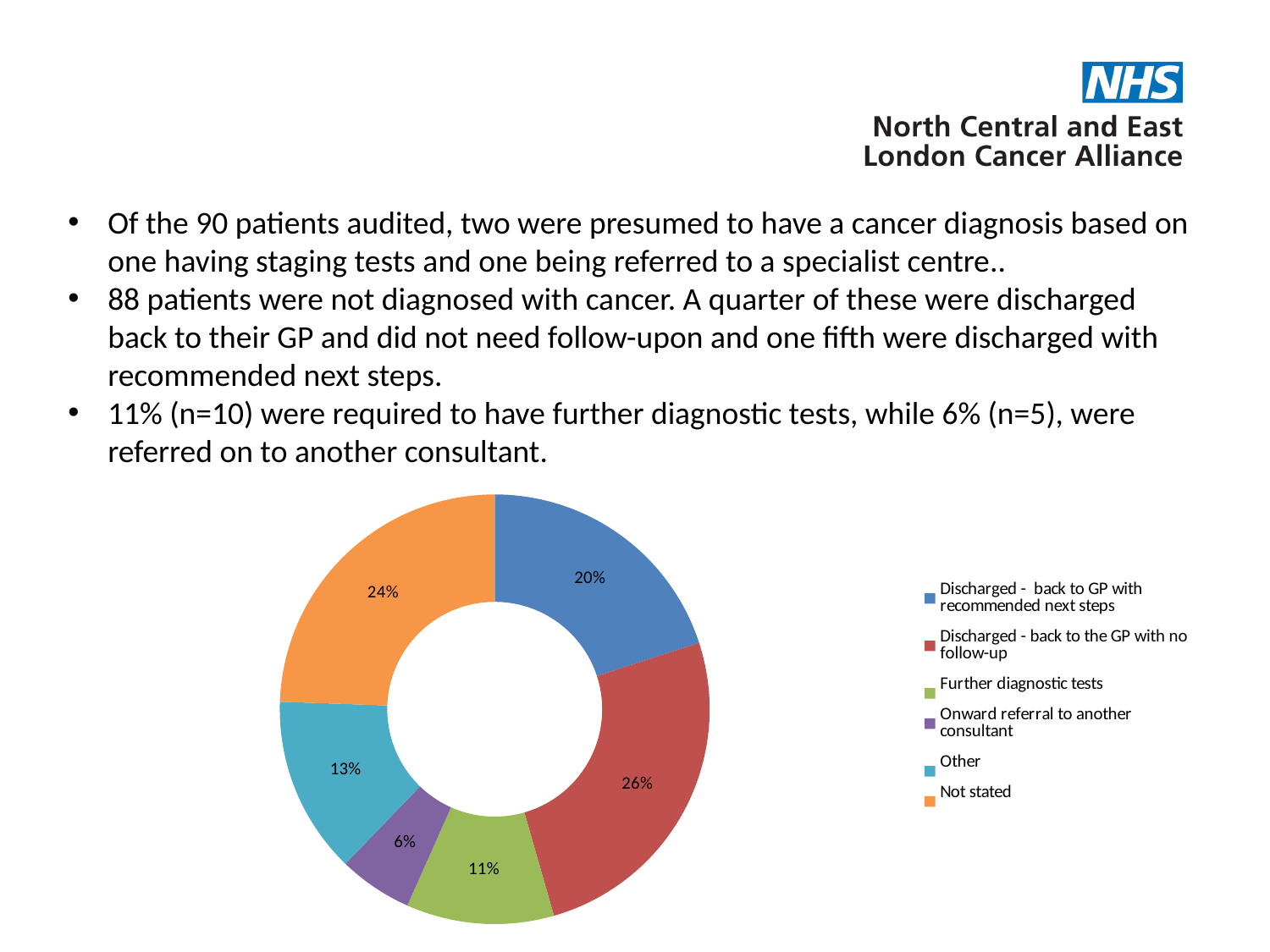
How many categories does the legend list? 6 What share of the chart is 'Other'? 13% Which category has the largest share of the chart? Discharged - back to the GP with no follow-up What share of the chart is 'Discharged - back to the GP with no follow-up'? 26% What share of the chart is 'Onward referral to another consultant'? 6% What colour is the 'Not stated' slice? Orange Which is larger: the share for 'Other' or the share for 'Further diagnostic tests'? Other What kind of chart is shown on the slide? Doughnut (pie) chart What is the difference in percentage points between 'Not stated' and 'Discharged - back to GP with recommended next steps'? 4 percentage points Which category has the smallest share of the chart? Onward referral to another consultant